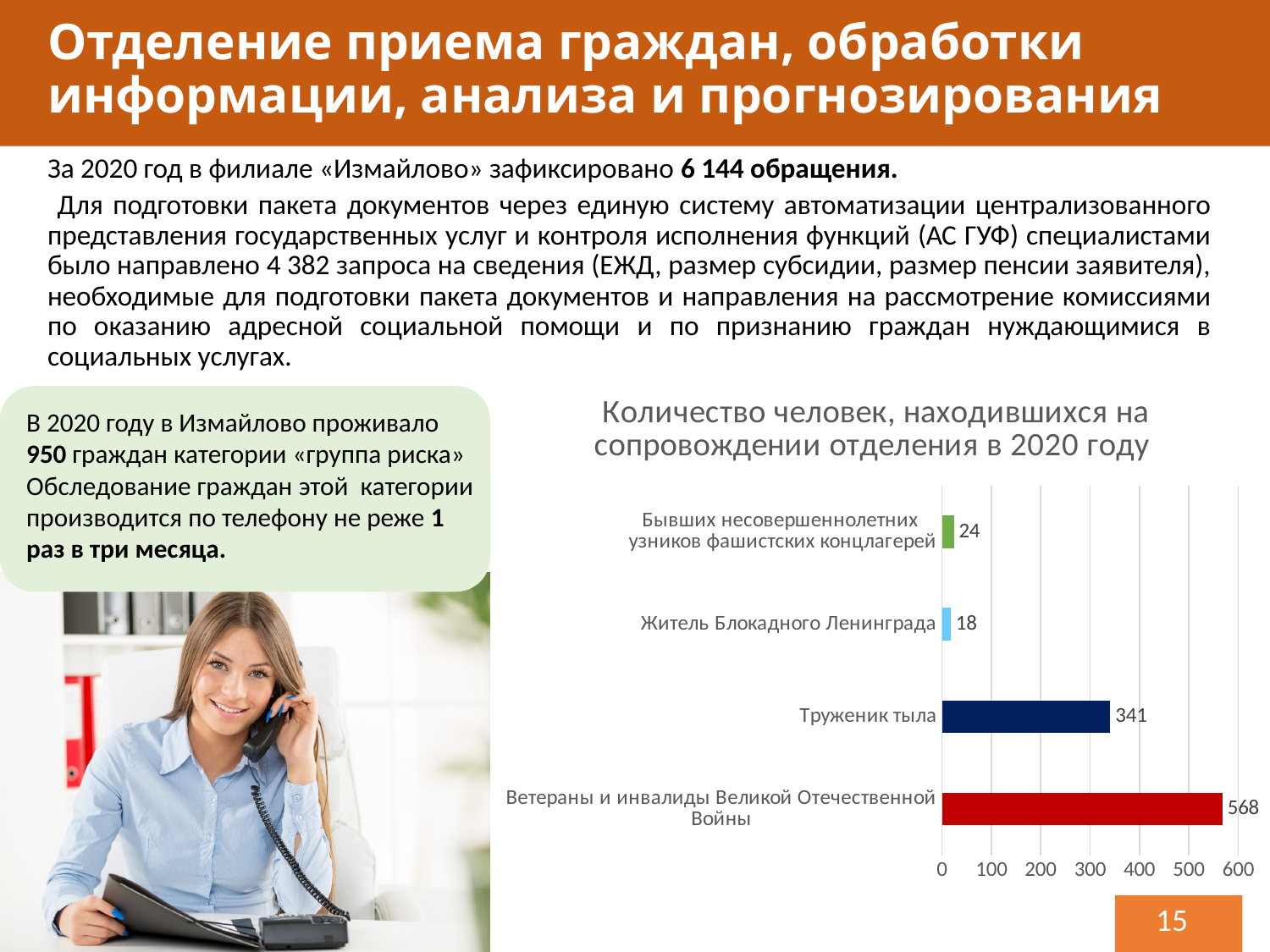
What is the difference between the values for «Ветераны и инвалиды Великой Отечественной Войны» and «Труженик тыла»? 227 What kind of chart is shown on the slide? bar chart How many categories are shown in the chart? 4 Which is larger: the value for «Бывших несовершеннолетних узников фашистских концлагерей» or for «Житель Блокадного Ленинграда»? Бывших несовершеннолетних узников фашистских концлагерей Is the value for «Труженик тыла» greater or less than 300? greater What is the value for «Житель Блокадного Ленинграда» in the chart? 18 What is the value for «Бывших несовершеннолетних узников фашистских концлагерей» in the chart? 24 What is the title of the chart? Количество человек, находившихся на сопровождении отделения в 2020 году Which category has the lowest value in the chart? Житель Блокадного Ленинграда What is the value for «Труженик тыла» in the chart? 341 What is the value for «Ветераны и инвалиды Великой Отечественной Войны» in the chart? 568 Which category has the highest value in the chart? Ветераны и инвалиды Великой Отечественной Войны